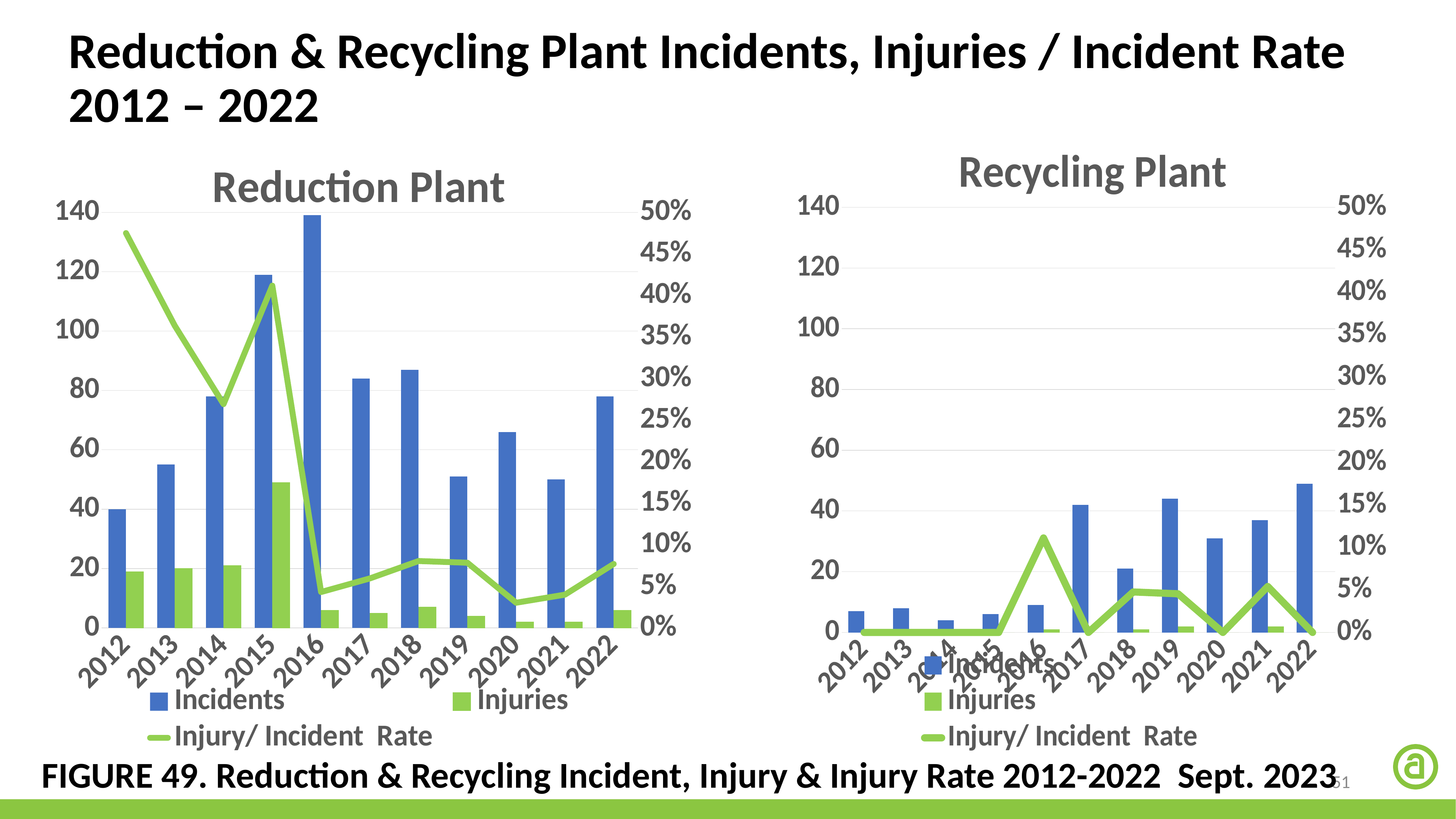
In the Reduction Plant chart, which year has the highest Injury/Incident Rate? 2012 What are the three legend entries in the Recycling Plant chart? Incidents, Injuries, Injury/ Incident Rate How many years are shown on the x axis of the Recycling Plant chart? 11 In the Reduction Plant chart, which year has the lowest number of incidents? 2012 In the Recycling Plant chart, which year has the highest Injury/Incident Rate? 2016 How many series does the legend of the Reduction Plant chart list? 3 In the Recycling Plant chart, is the number of incidents in 2022 greater or less than 60? less In the Reduction Plant chart, is the number of incidents in 2016 greater or less than 120? greater In the Reduction Plant chart, which year has more injuries, 2014 or 2015? 2015 In the Reduction Plant chart, which year has the highest number of incidents? 2016 What kind of chart is the Reduction Plant chart? A combined bar and line chart In the Reduction Plant chart, is the number of incidents in 2015 greater or less than 100? greater